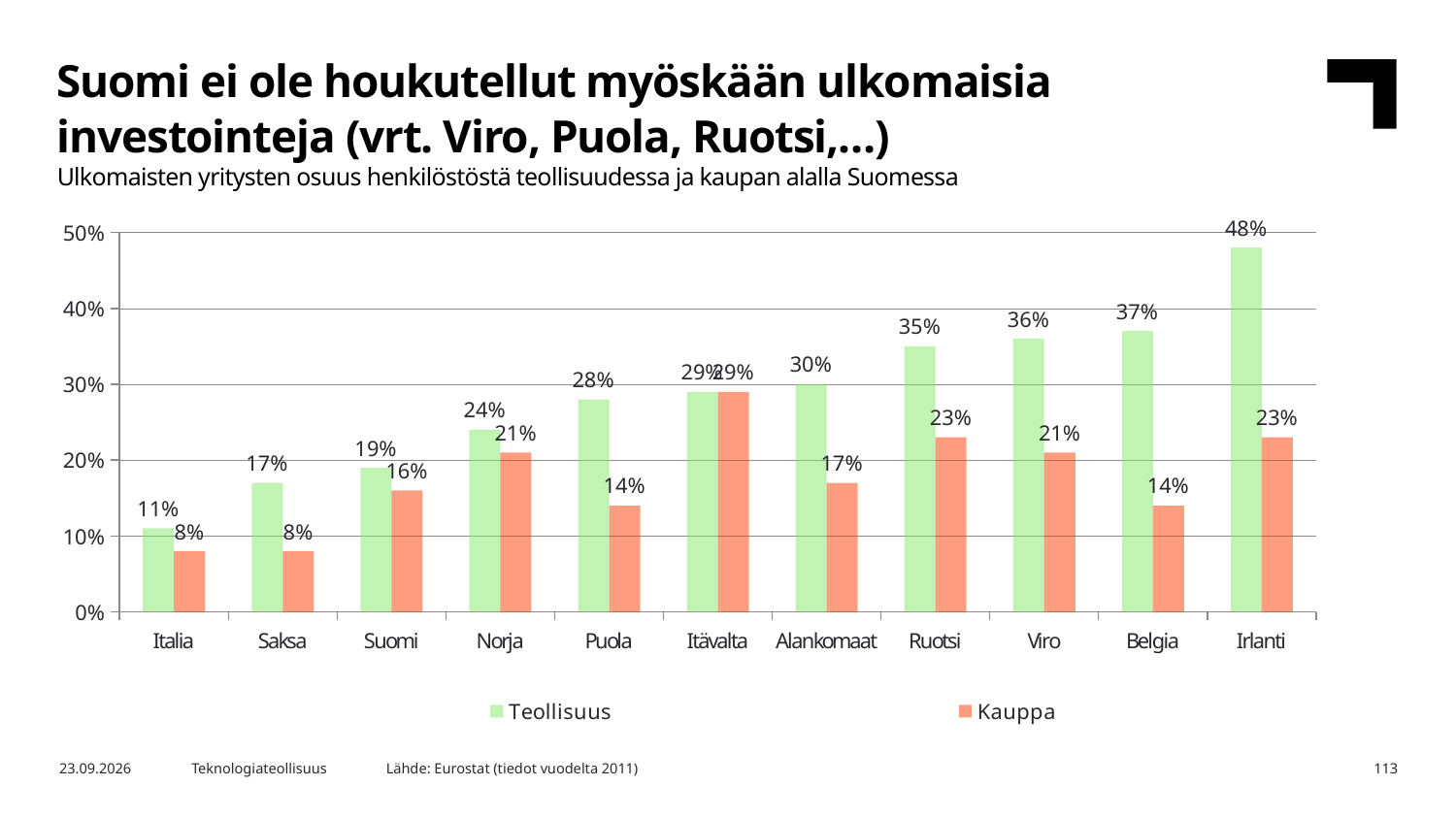
Which country has the lowest Teollisuus value? Italia How many series does the legend list? 2 How many countries are shown on the x axis? 11 Do the Teollisuus values rise or fall from Italia to Irlanti along the x axis? Rise Which country has the highest Teollisuus value? Irlanti What kind of chart is shown on the slide? Bar chart Which country has the highest Kauppa value? Itävalta What is the Kauppa value for Viro? 21% Which is larger, the Kauppa value for Ruotsi or the Kauppa value for Puola? Ruotsi What is the difference between the Teollisuus values for Belgia and Suomi? 18 percentage points What is the Teollisuus value for Irlanti? 48% What is the Teollisuus value for Suomi? 19%